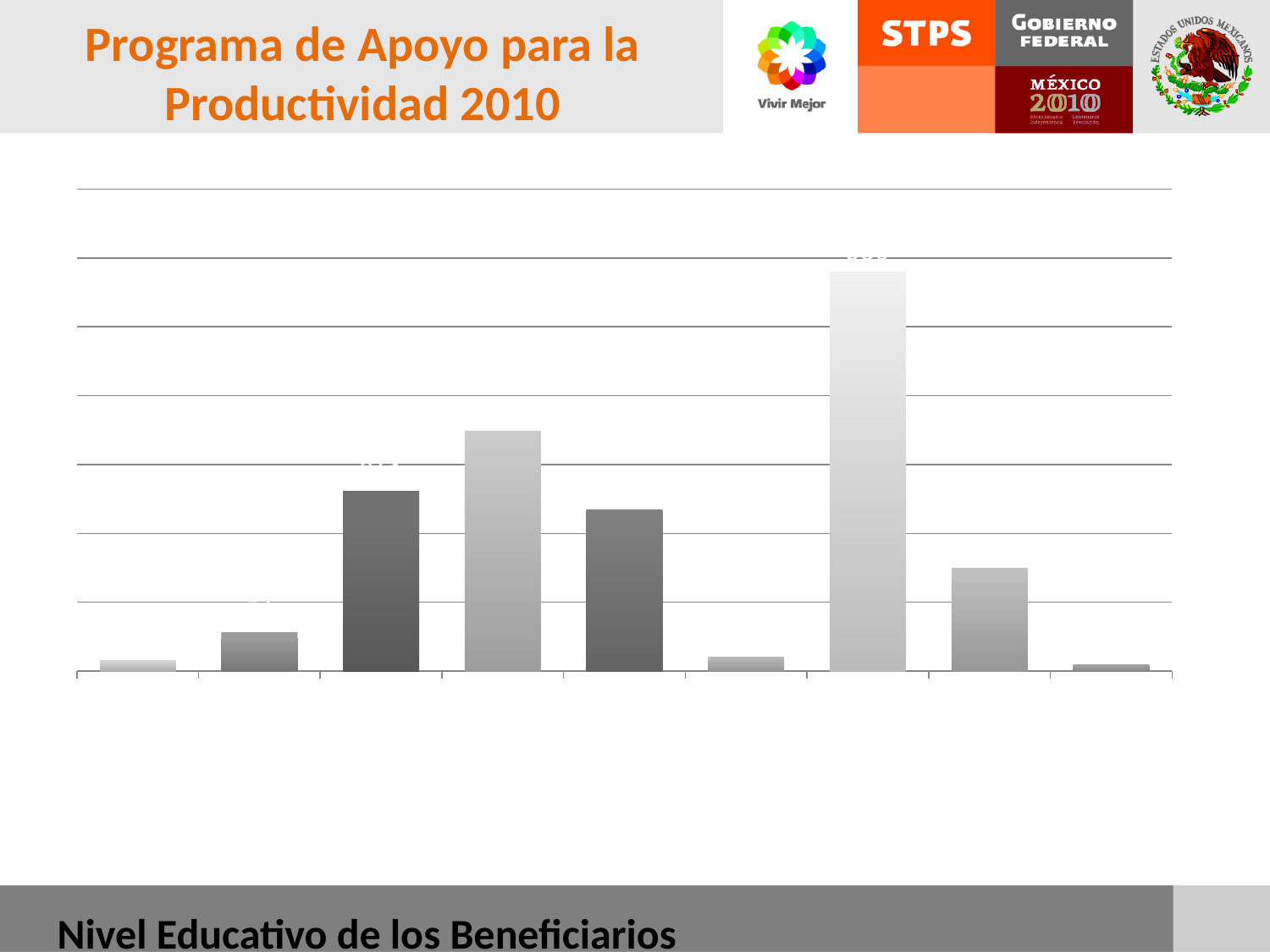
Which bar, counted from the left, is the tallest in the chart? the 7th bar Which is taller, the 3rd bar from the left or the 4th bar from the left? the 4th bar Does the chart show a legend? No Which is taller, the 3rd bar from the left or the 5th bar from the left? the 3rd bar What kind of chart is shown on the slide? bar chart What caption is shown beneath the chart on the slide? Nivel Educativo de los Beneficiarios Which is taller, the 4th bar from the left or the 7th bar from the left? the 7th bar How many bars are plotted in the chart? 9